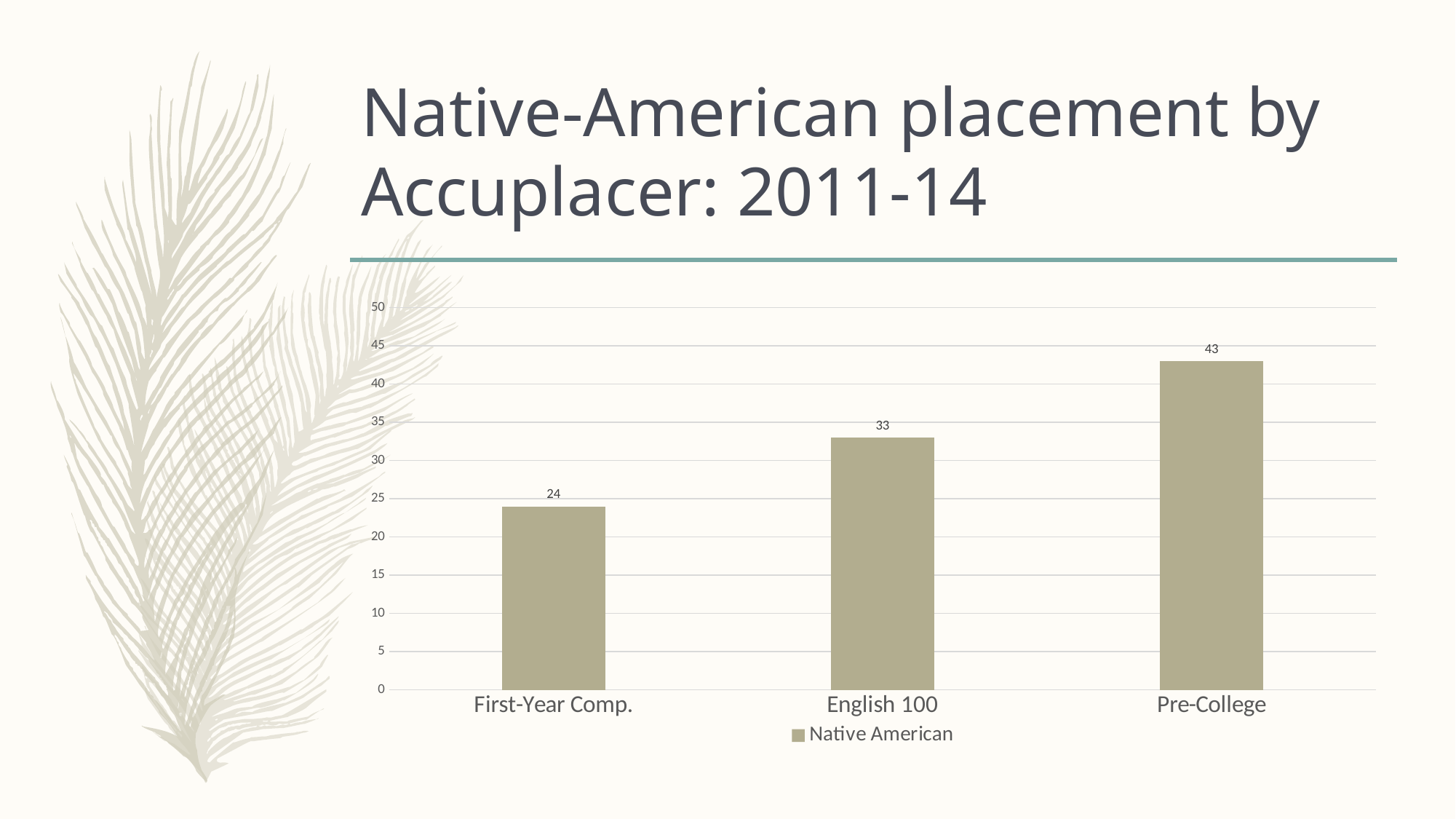
Which is larger, the value for English 100 or the value for Pre-College? Pre-College What kind of chart is shown on the slide? bar chart Is the value for English 100 greater or less than 30? greater Which category has the lowest value? First-Year Comp. How many categories are shown on the x axis? 3 What is the value for Pre-College? 43 What is the difference between the values for English 100 and First-Year Comp.? 9 Which category has the highest value? Pre-College What is the difference between the values for Pre-College and First-Year Comp.? 19 What series does the legend list? Native American What is the value for English 100? 33 What is the value for First-Year Comp.? 24